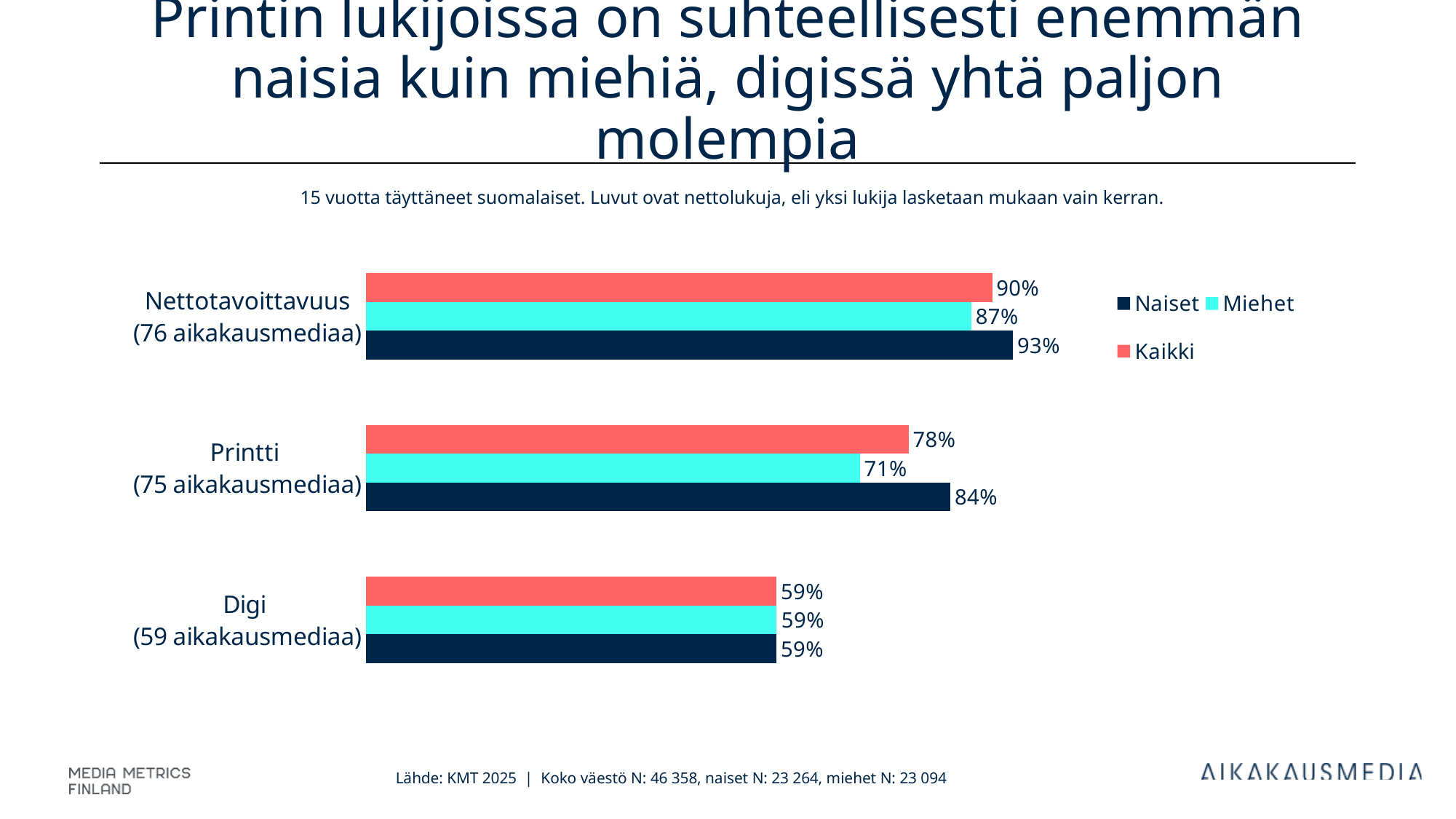
What is the difference between the Kaikki values for Nettotavoittavuus (76 aikakausmediaa) and Printti (75 aikakausmediaa)? 12% How many categories are shown on the chart? 3 What is the value for Miehet in the Printti (75 aikakausmediaa) category? 71% Which category has the highest value for Naiset? Nettotavoittavuus (76 aikakausmediaa) How many series does the legend list? 3 What is the value for Miehet in the Nettotavoittavuus (76 aikakausmediaa) category? 87% What is the value for Kaikki in the Digi (59 aikakausmediaa) category? 59% What is the difference between the Naiset and Miehet values in the Printti (75 aikakausmediaa) category? 13% In the Nettotavoittavuus (76 aikakausmediaa) category, which is larger: the Naiset value or the Miehet value? Naiset What kind of chart is shown on the slide? Bar chart What is the value for Naiset in the Printti (75 aikakausmediaa) category? 84% Which category has the lowest value for Kaikki? Digi (59 aikakausmediaa)